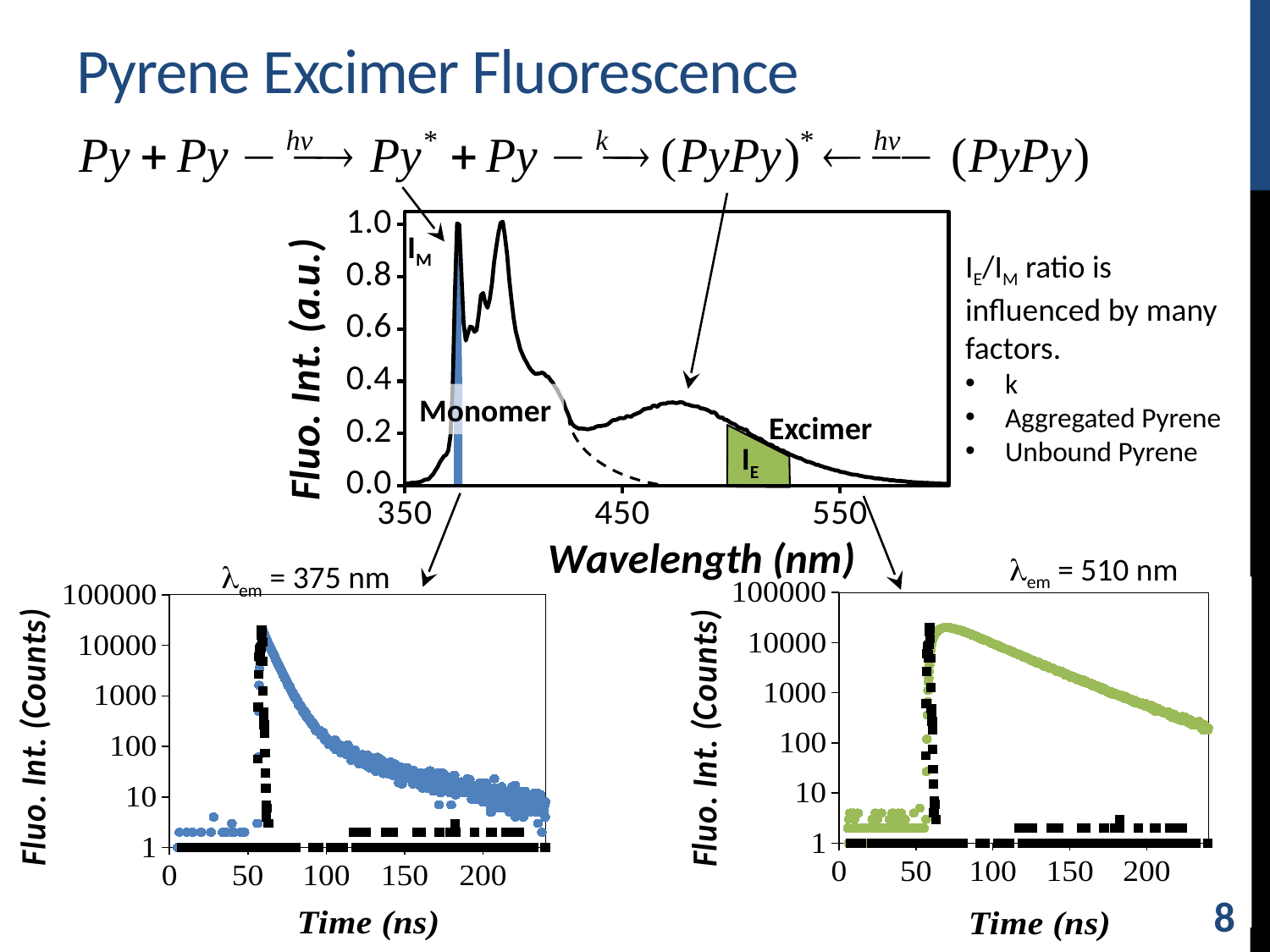
In the top chart, what is the label on the y axis? Fluo. Int. (a.u.) In the bottom-left chart (λem = 375 nm), do the blue values rise or fall with time after the peak near 60 ns? fall In the top chart, which labelled region has the higher peak intensity, Monomer or Excimer? Monomer In the top chart, is the peak intensity of the Excimer band greater or less than 0.2? greater In the bottom-right chart (λem = 510 nm), is the green value at 200 ns greater or less than 100? greater What kind of chart is the top chart showing fluorescence intensity versus wavelength? line chart Which of the two bottom charts shows the slower decay of fluorescence intensity with time, λem = 375 nm or λem = 510 nm? λem = 510 nm In the top chart, what is the label on the x axis? Wavelength (nm) In the top chart, what is the maximum value shown on the y axis? 1.0 What kind of chart is the bottom-left chart labelled λem = 375 nm? scatter chart In the bottom-left chart (λem = 375 nm), is the blue value at 200 ns greater or less than 100? less